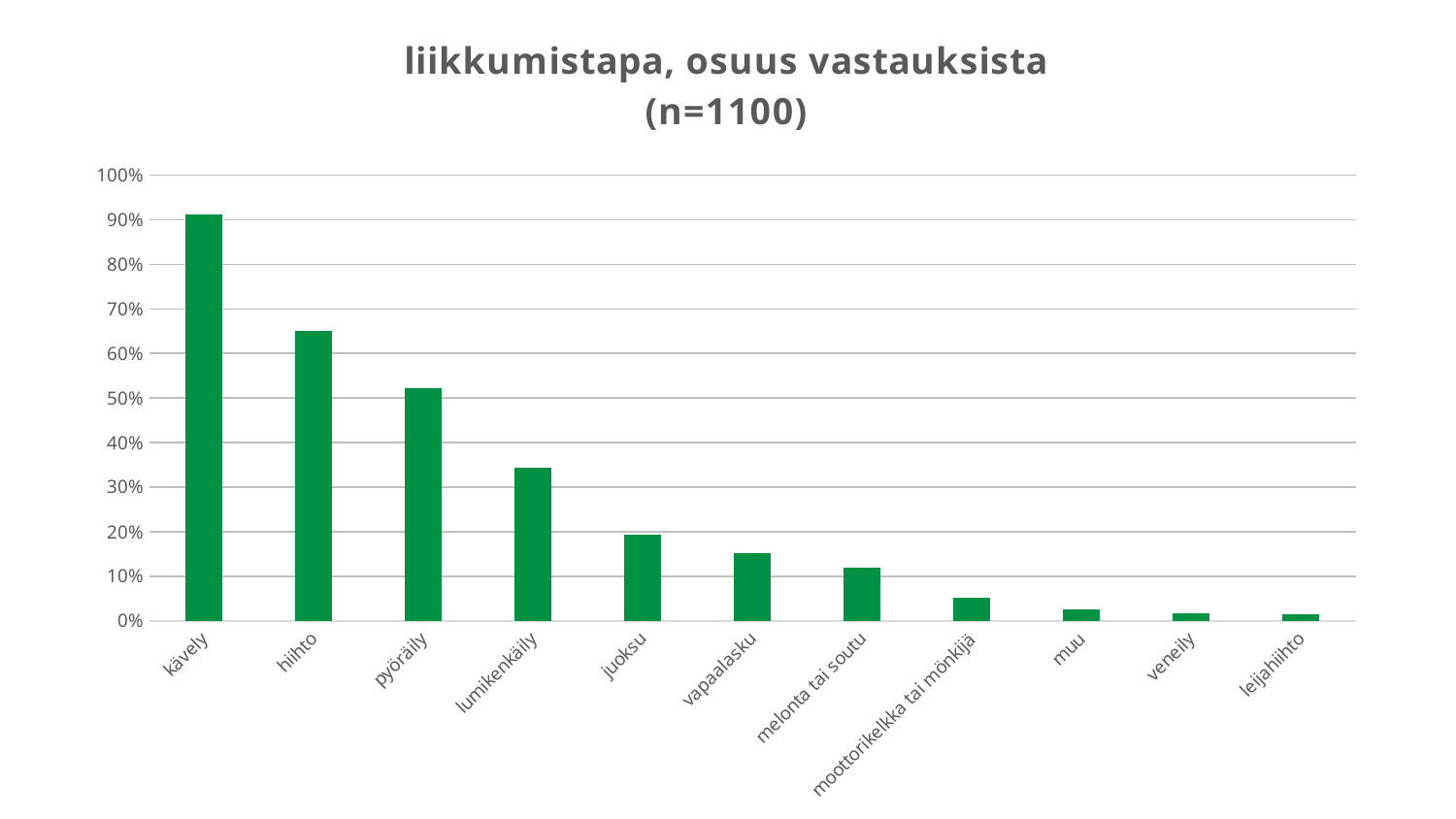
Is the value for pyöräily greater or less than 60%? less Is the value for moottorikelkka tai mönkijä greater or less than 10%? less Which category has the highest value? kävely How many categories are shown on the x axis? 11 Which is larger, the value for vapaalasku or the value for melonta tai soutu? vapaalasku Do the values rise or fall from left to right along the x axis? fall What is the title of the chart? liikkumistapa, osuus vastauksista (n=1100) Is the value for kävely greater or less than 90%? greater What kind of chart is shown on the slide? bar chart